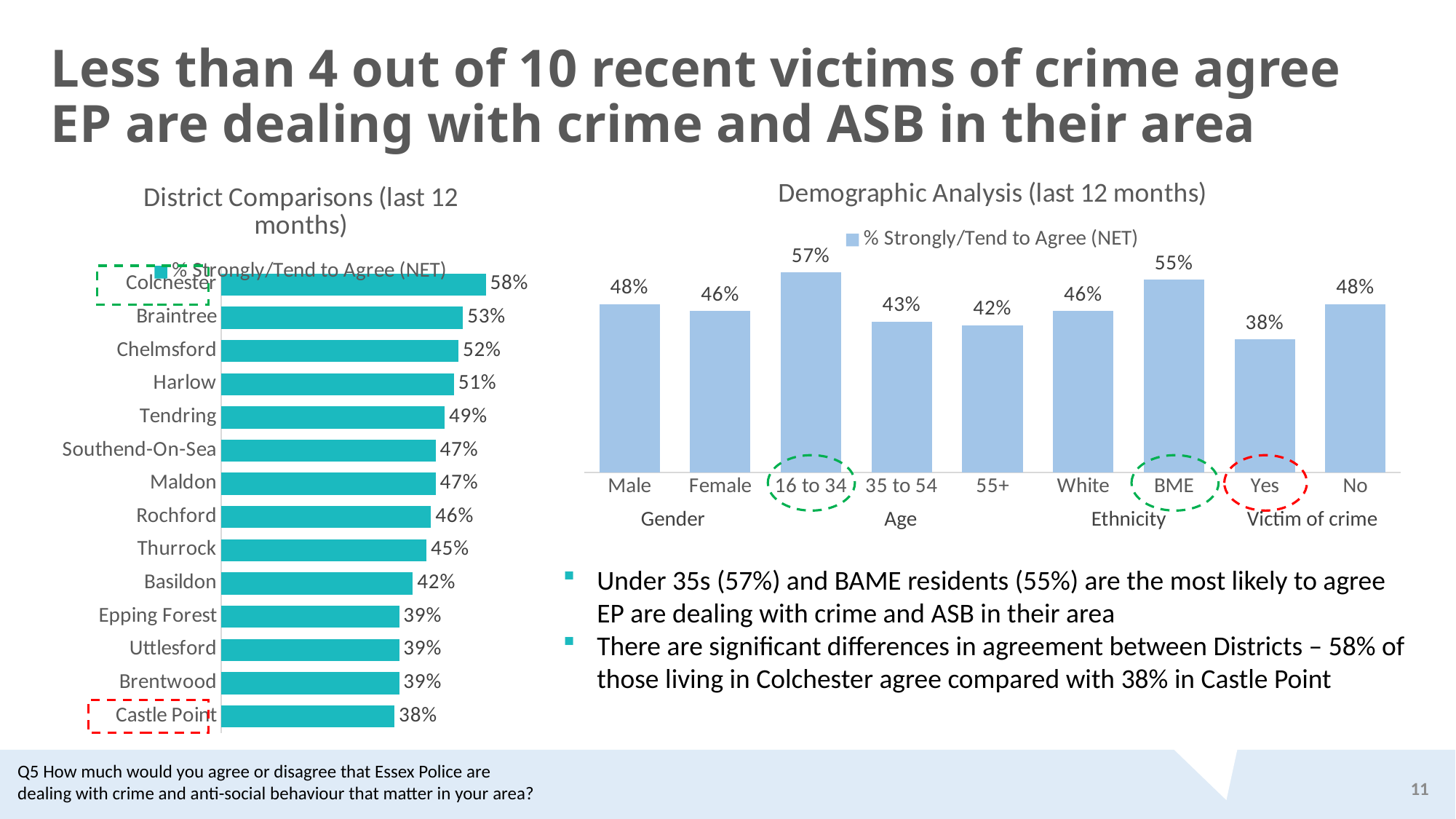
In the Demographic Analysis chart, what is the difference between Male and Female? 2 percentage points In the District Comparisons chart, which district has the highest value? Colchester In the Demographic Analysis chart, what is the value for BME? 55% In the District Comparisons chart, how many districts are shown? 14 In the District Comparisons chart, which is larger, Braintree or Basildon? Braintree In the Demographic Analysis chart, which category has the lowest value? Yes In the District Comparisons chart, which district has the lowest value? Castle Point In the Demographic Analysis chart, how many categories are plotted? 9 What type of chart is the Demographic Analysis chart? Bar chart In the Demographic Analysis chart, which category has the highest value? 16 to 34 In the District Comparisons chart, what is the difference between Colchester and Castle Point? 20 percentage points In the District Comparisons chart, what is the value for Chelmsford? 52%